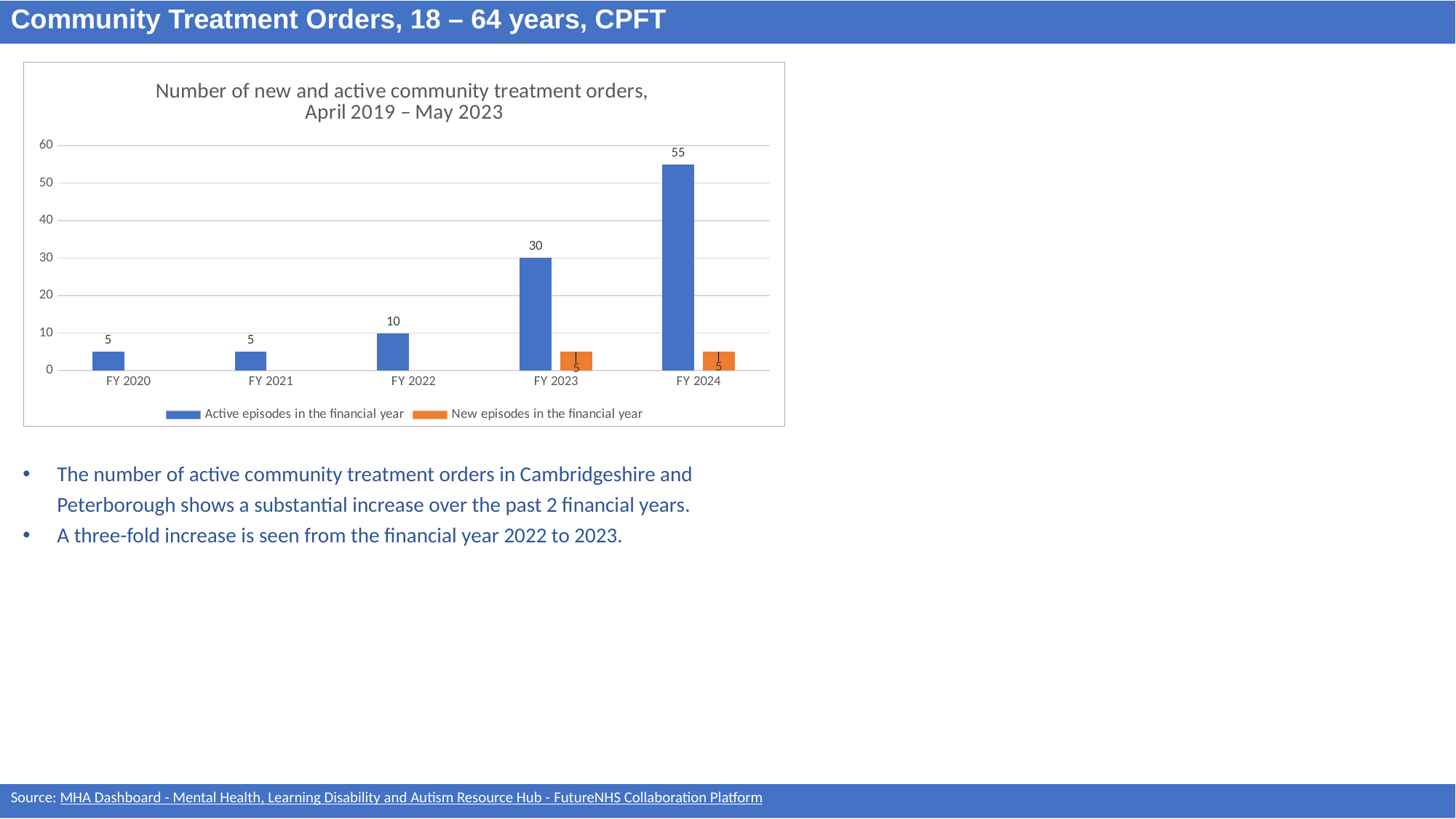
What is the value for Active episodes in the financial year in FY 2024? 55 What is the value for Active episodes in the financial year in FY 2022? 10 What kind of chart is shown on the slide? Bar chart Is the value for Active episodes in the financial year in FY 2024 greater or less than 50? greater How many series does the legend list? 2 What is the value for New episodes in the financial year in FY 2023? 5 Do the values for Active episodes in the financial year rise or fall from FY 2020 to FY 2024? Rise What is the difference between Active episodes in the financial year in FY 2024 and FY 2023? 25 What is the difference between Active episodes in the financial year in FY 2023 and FY 2022? 20 How many financial years are shown on the x axis? 5 Which is larger: Active episodes in the financial year in FY 2023 or in FY 2021? FY 2023 Which financial year has the highest value for Active episodes in the financial year? FY 2024